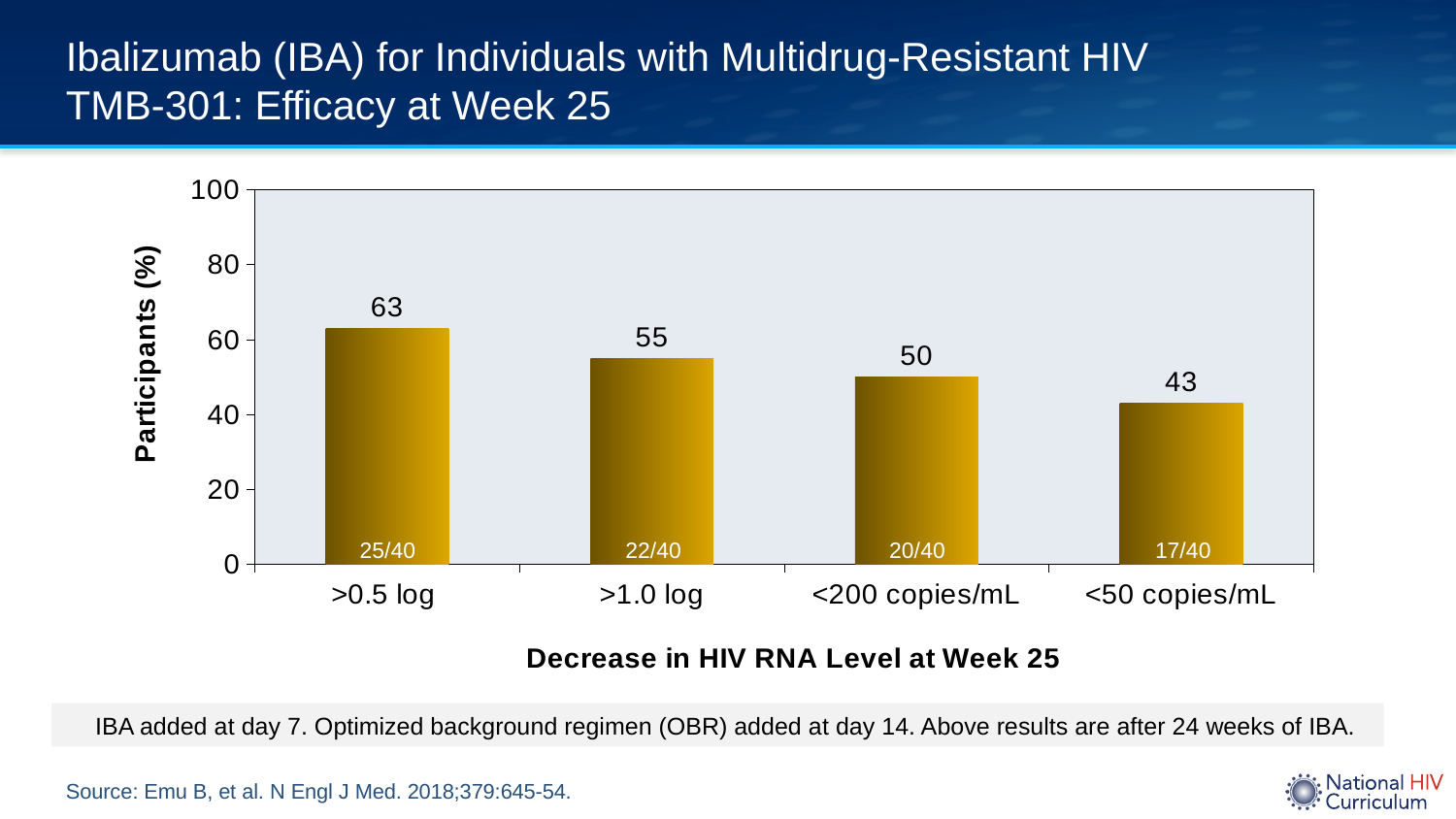
What percentage of participants had a >0.5 log decrease in HIV RNA level at week 25? 63 Which category has the highest percentage of participants? >0.5 log What fraction of participants is printed inside the <200 copies/mL bar? 20/40 Do the values rise or fall from left to right along the x axis? Fall What percentage of participants reached <50 copies/mL at week 25? 43 What is the difference in percentage points between the >0.5 log bar and the <50 copies/mL bar? 20 What percentage of participants reached <200 copies/mL at week 25? 50 How many categories are shown on the x axis? 4 What kind of chart is shown on the slide? Bar chart What percentage of participants had a >1.0 log decrease in HIV RNA level at week 25? 55 Which category has the lowest percentage of participants? <50 copies/mL Which is larger: the percentage for >1.0 log or for <200 copies/mL? >1.0 log